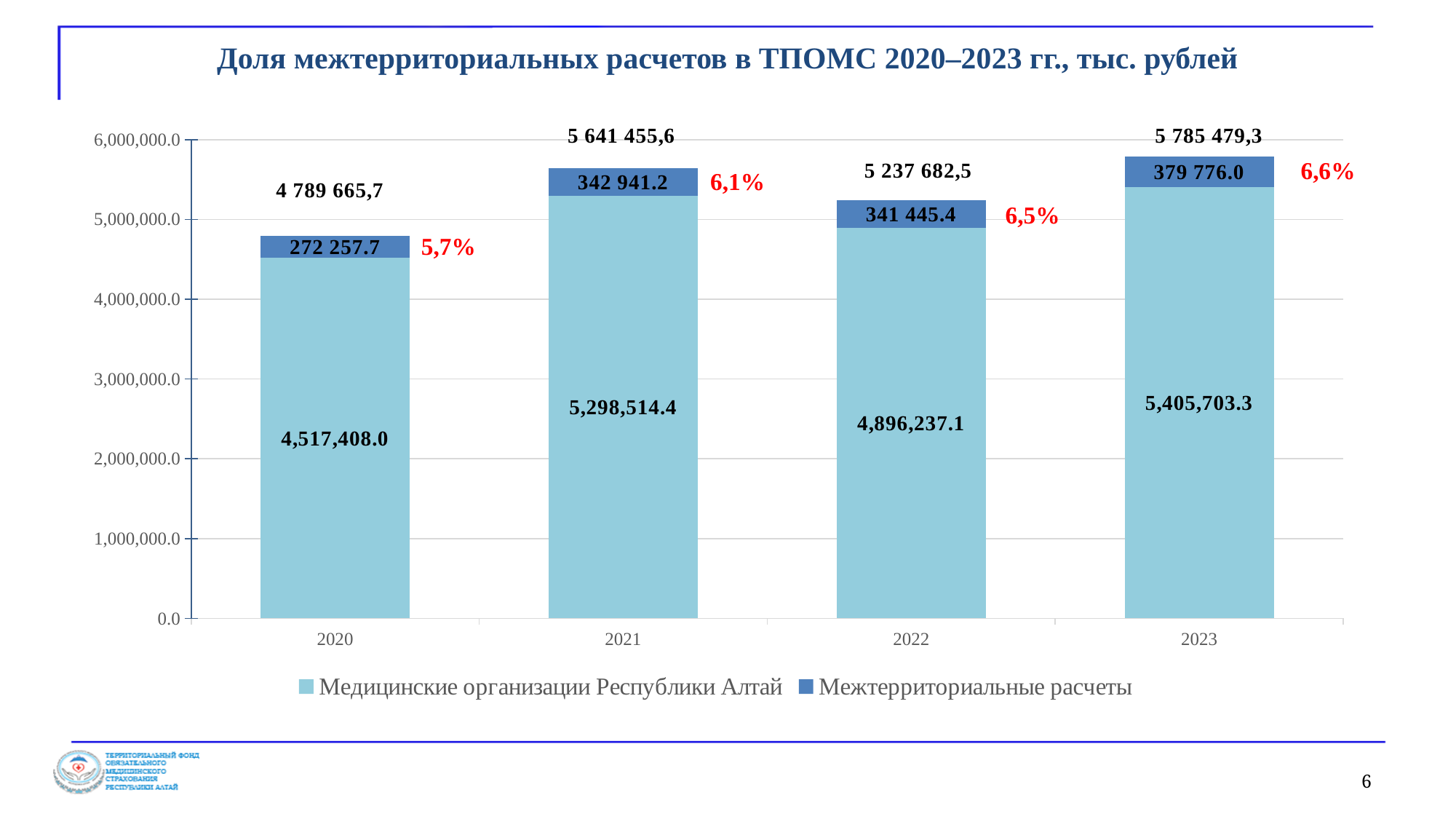
What is the red percentage label shown next to the 2022 bar? 6,5% In which year is the value for Межтерриториальные расчеты the highest? 2023 What is the value for Медицинские организации Республики Алтай in 2020? 4,517,408.0 In which year is the value for Медицинские организации Республики Алтай the lowest? 2020 What is the total of the stacked bar for 2021? 5 641 455,6 What is the value for Межтерриториальные расчеты in 2023? 379 776.0 Do the red percentage labels rise or fall from 2020 to 2023? Rise Which year has the larger value for Медицинские организации Республики Алтай, 2021 or 2022? 2021 What is the difference between the Межтерриториальные расчеты values for 2023 and 2020? 107 518.3 How many years are shown on the x axis? 4 How many series does the legend list? 2 What kind of chart is shown on the slide? Stacked bar chart